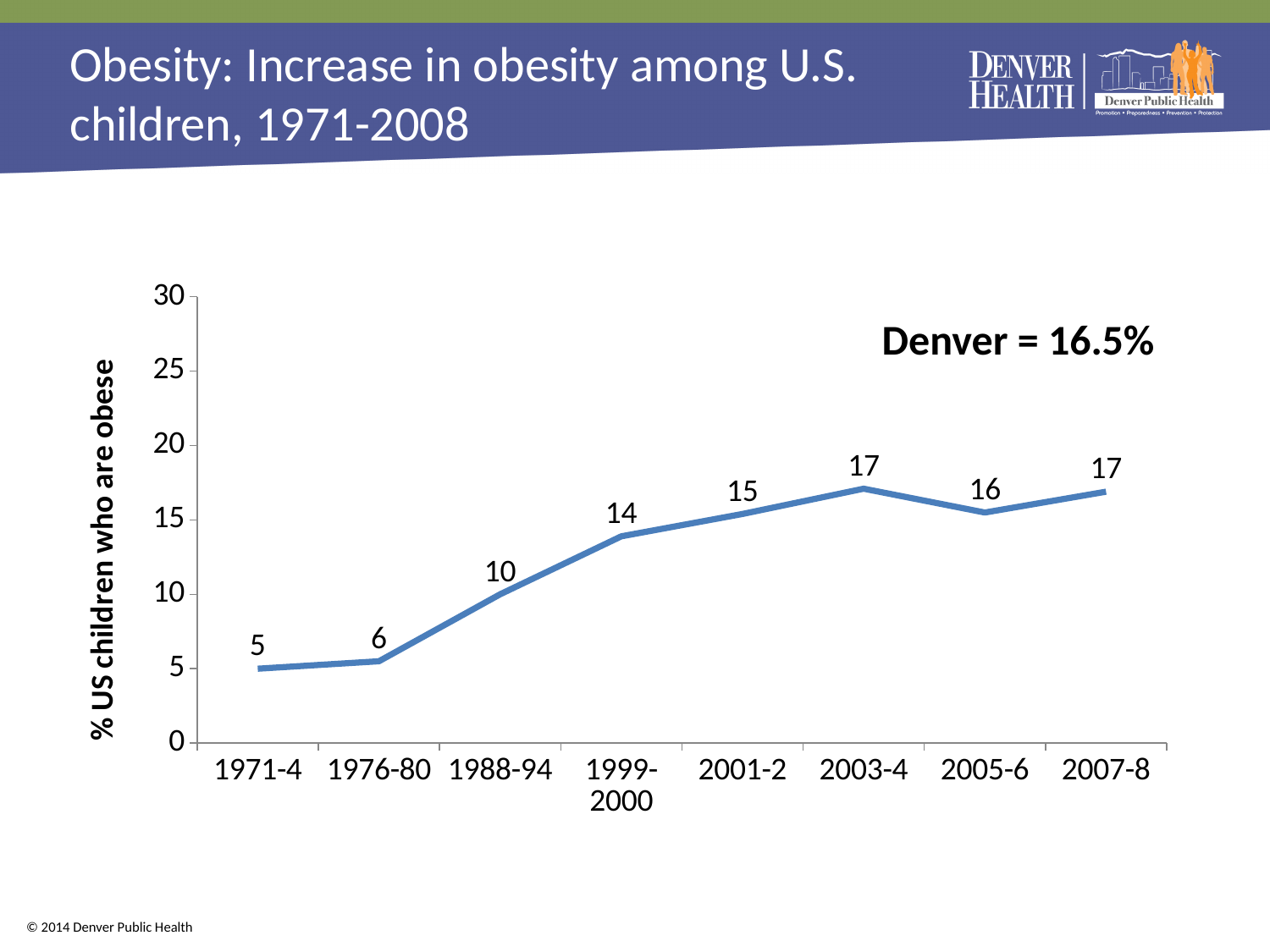
What is the value for 1971-4? 5 What kind of chart is shown? line chart What is the difference between the values for 1999-2000 and 1976-80? 8 What is the y-axis label of the chart? % US children who are obese Is the value for 2003-4 greater or less than 20? less Which is larger, the value for 2001-2 or the value for 1988-94? 2001-2 Which period has the lowest value? 1971-4 What is the value for 2005-6? 16 What is the value for 1988-94? 10 What is the value for 1999-2000? 14 Do the values generally rise or fall from 1971-4 to 2007-8? rise How many time periods are plotted on the x axis? 8